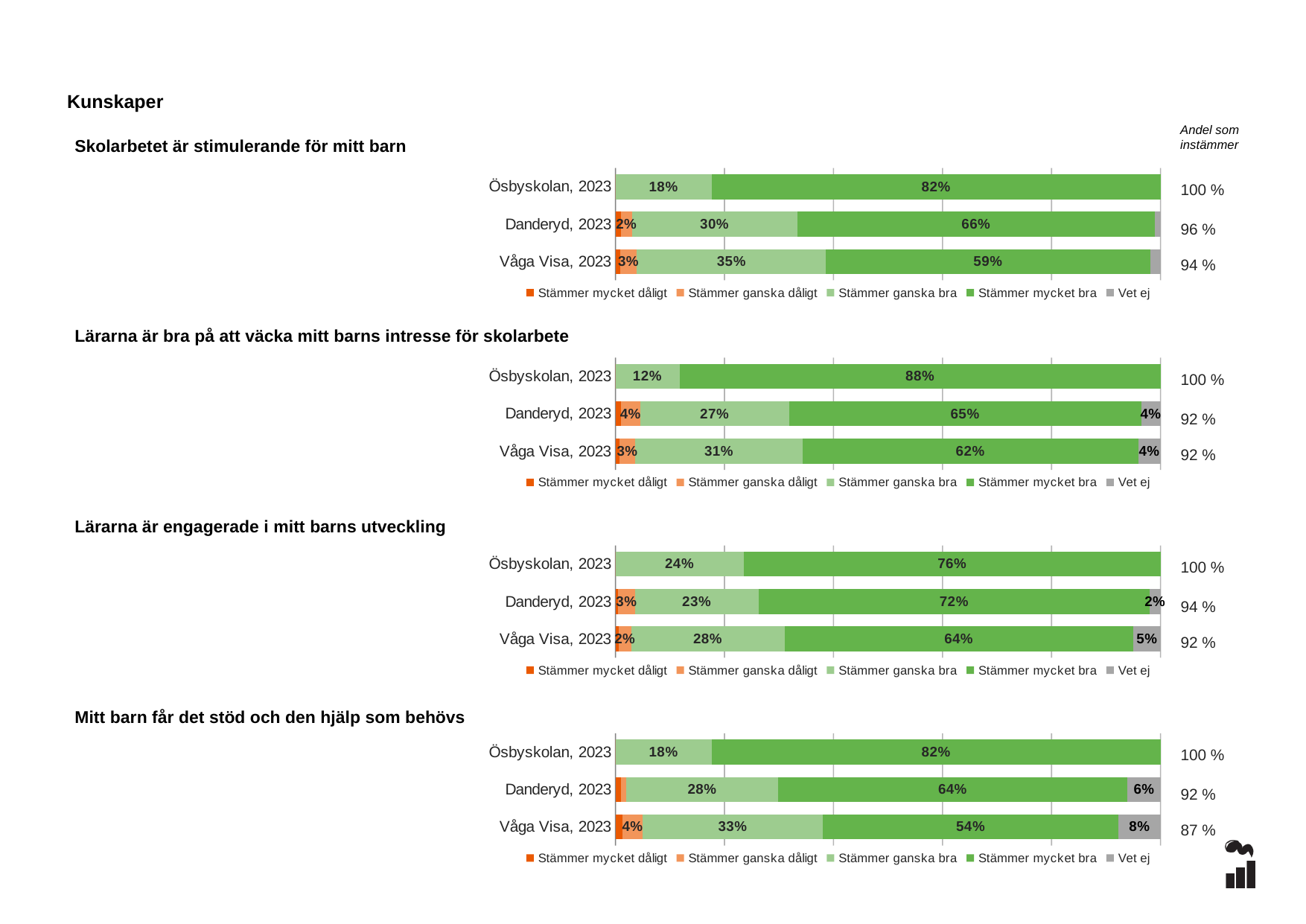
What kind of chart is used for 'Mitt barn får det stöd och den hjälp som behövs'? Stacked bar chart In the chart 'Lärarna är bra på att väcka mitt barns intresse för skolarbete', what is the 'Stämmer mycket bra' value for Danderyd, 2023? 65% In the chart 'Lärarna är engagerade i mitt barns utveckling', what is the 'Vet ej' value for Våga Visa, 2023? 5% How many series does the legend list for the chart 'Skolarbetet är stimulerande för mitt barn'? 5 In the chart 'Lärarna är engagerade i mitt barns utveckling', what is the difference between the 'Stämmer mycket bra' values for Danderyd, 2023 and Våga Visa, 2023? 8% In the chart 'Mitt barn får det stöd och den hjälp som behövs', is the 'Stämmer ganska bra' value larger for Danderyd, 2023 or Våga Visa, 2023? Våga Visa, 2023 In the chart 'Skolarbetet är stimulerande för mitt barn', what is the 'Stämmer ganska bra' value for Våga Visa, 2023? 35% In the chart 'Mitt barn får det stöd och den hjälp som behövs', what is the 'Vet ej' value for Våga Visa, 2023? 8% In the chart 'Mitt barn får det stöd och den hjälp som behövs', which category has the lowest 'Stämmer mycket bra' value? Våga Visa, 2023 In the chart 'Lärarna är bra på att väcka mitt barns intresse för skolarbete', which category has the highest 'Stämmer mycket bra' value? Ösbyskolan, 2023 How many categories are shown in the chart 'Lärarna är engagerade i mitt barns utveckling'? 3 In the chart 'Skolarbetet är stimulerande för mitt barn', what is the 'Stämmer mycket bra' value for Ösbyskolan, 2023? 82%